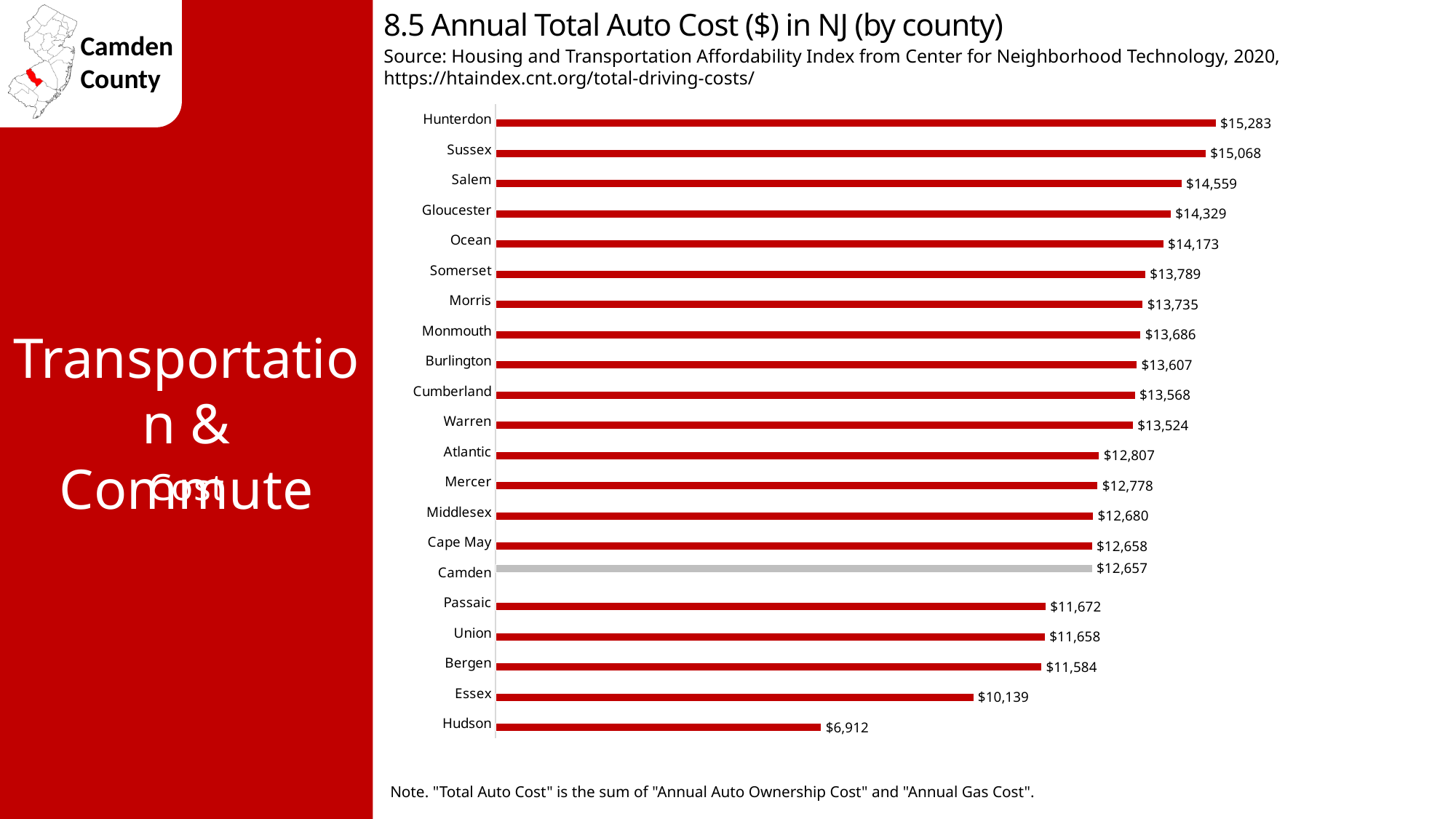
What is the difference in annual total auto cost between Hunterdon and Hudson counties? $8,371 Which county has a higher annual total auto cost, Sussex or Salem? Sussex Which county has a higher annual total auto cost, Bergen or Essex? Bergen Which county has the highest annual total auto cost? Hunterdon What is the annual total auto cost for Camden County? $12,657 Which county has the lowest annual total auto cost? Hudson What type of chart is used to show annual total auto cost by county? Bar chart What is the annual total auto cost for Gloucester County? $14,329 How much higher is the annual total auto cost in Gloucester County than in Camden County? $1,672 What is the annual total auto cost for Essex County? $10,139 How many counties are shown in the chart? 21 Which county's bar is shown in gray rather than red? Camden